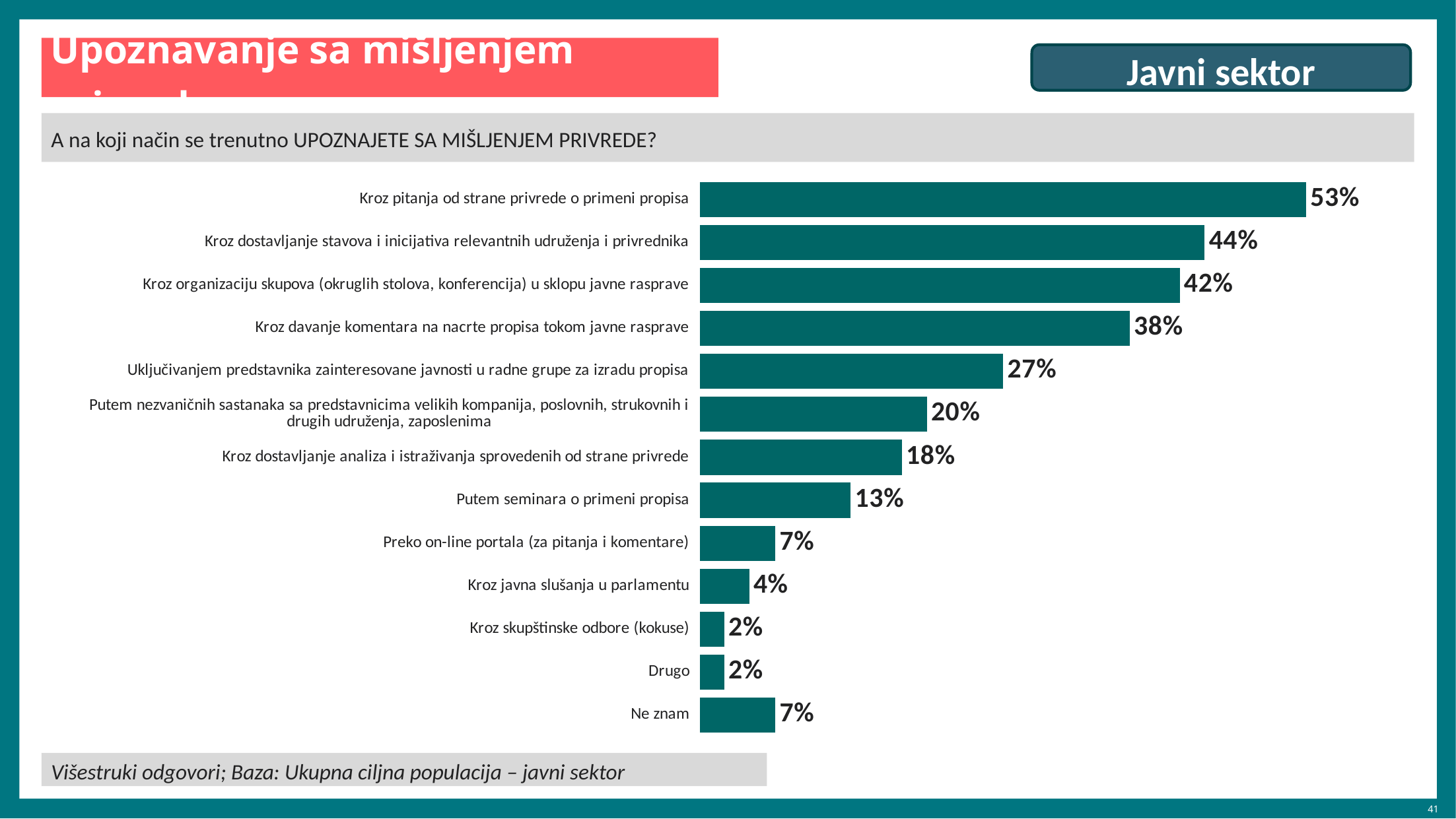
What question is the chart answering, as shown in the grey box above it? A na koji način se trenutno UPOZNAJETE SA MIŠLJENJEM PRIVREDE? What is the difference between "Kroz dostavljanje stavova i inicijativa relevantnih udruženja i privrednika" and "Kroz organizaciju skupova (okruglih stolova, konferencija) u sklopu javne rasprave"? 2% What is the difference between "Kroz davanje komentara na nacrte propisa tokom javne rasprave" and "Uključivanjem predstavnika zainteresovane javnosti u radne grupe za izradu propisa"? 11% Which category has the highest value? Kroz pitanja od strane privrede o primeni propisa What is the value for "Kroz pitanja od strane privrede o primeni propisa"? 53% What kind of chart is shown on the slide? Bar chart What is the value for "Ne znam"? 7% Which categories share the lowest value of 2%? Kroz skupštinske odbore (kokuse) and Drugo Which is larger: "Kroz dostavljanje analiza i istraživanja sprovedenih od strane privrede" or "Putem nezvaničnih sastanaka sa predstavnicima velikih kompanija, poslovnih, strukovnih i drugih udruženja, zaposlenima"? Putem nezvaničnih sastanaka sa predstavnicima velikih kompanija, poslovnih, strukovnih i drugih udruženja, zaposlenima What is the value for "Kroz javna slušanja u parlamentu"? 4% What is the value for "Putem seminara o primeni propisa"? 13% How many categories are shown in the chart? 13